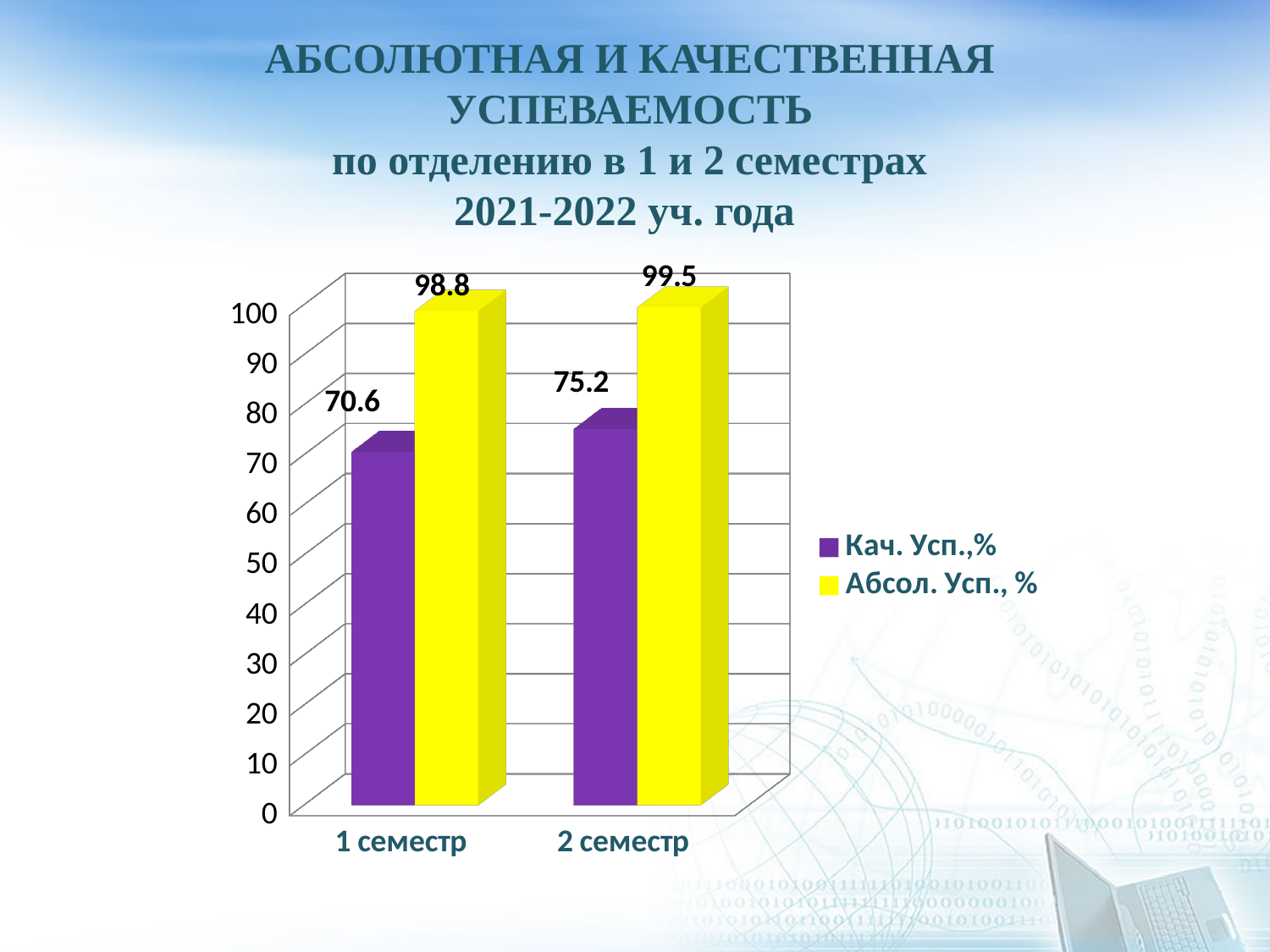
What is the difference between Абсол. Усп., % and Кач. Усп.,% in 1 семестр? 28.2 Which is larger in 2 семестр: Кач. Усп.,% or Абсол. Усп., %? Абсол. Усп., % What kind of chart is shown on the slide? Bar chart What is the value of Кач. Усп.,% for 2 семестр? 75.2 Which semester has the lower Абсол. Усп., % value? 1 семестр How many series does the legend list? 2 What is the difference between Кач. Усп.,% in 2 семестр and 1 семестр? 4.6 Which semester has the higher Кач. Усп.,% value? 2 семестр What is the value of Абсол. Усп., % for 2 семестр? 99.5 What is the value of Абсол. Усп., % for 1 семестр? 98.8 How many categories are shown on the x axis? 2 What is the value of Кач. Усп.,% for 1 семестр? 70.6